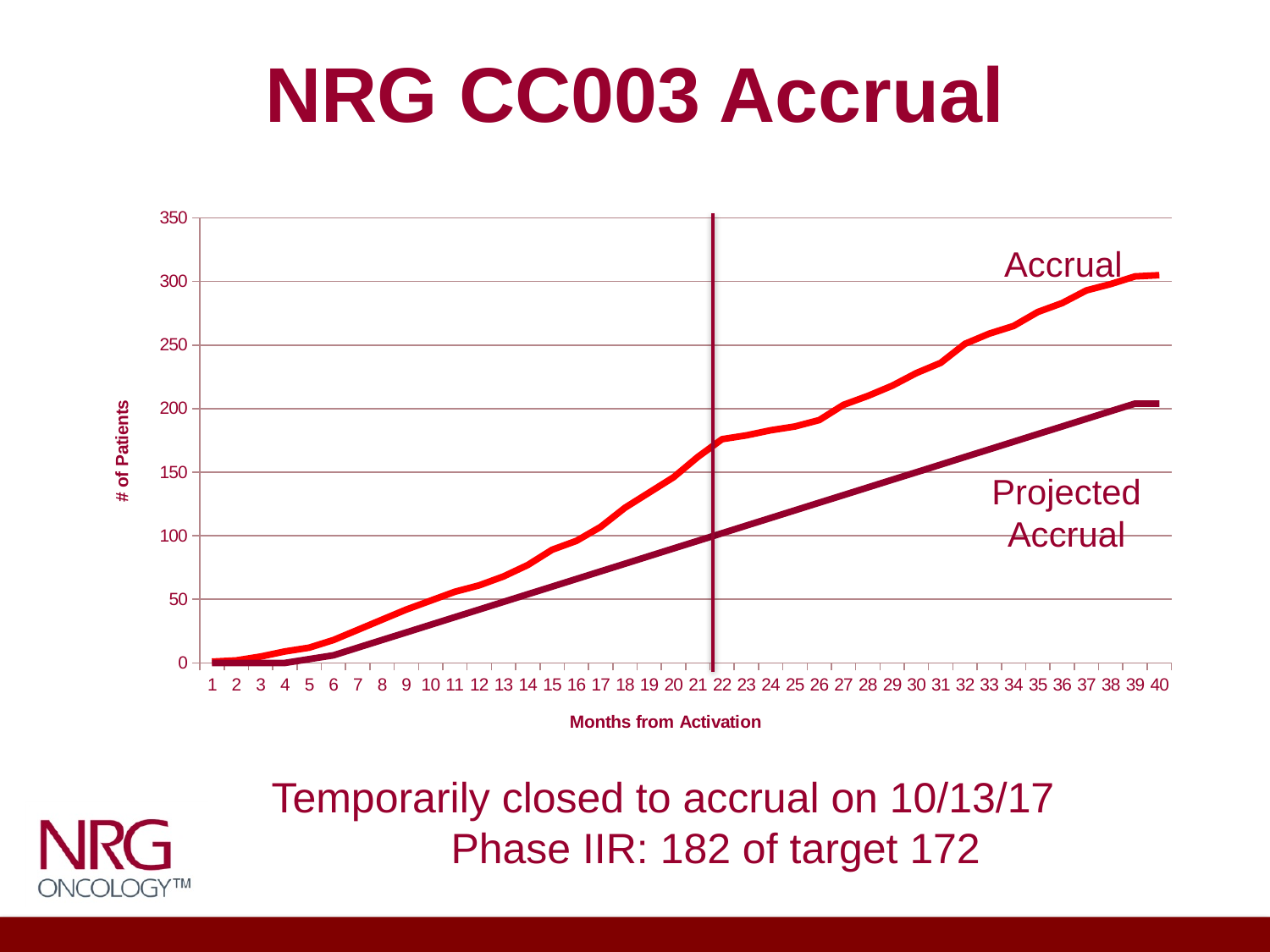
At month 30, which series has the higher value, Accrual or Projected Accrual? Accrual What kind of chart is shown on the slide? line chart How many months are shown along the x axis of the chart? 40 What is the label of the x axis of the chart? Months from Activation Is the Accrual value at month 22 greater or less than 150? greater How many series are plotted on the chart? 2 Is the Accrual value at month 15 greater or less than 100? less Does the Accrual line rise or fall as months from activation increase? rise Is the Projected Accrual value at month 10 greater or less than 50? less Which series reaches the higher value at month 40? Accrual What is the title of the chart on the slide? NRG CC003 Accrual